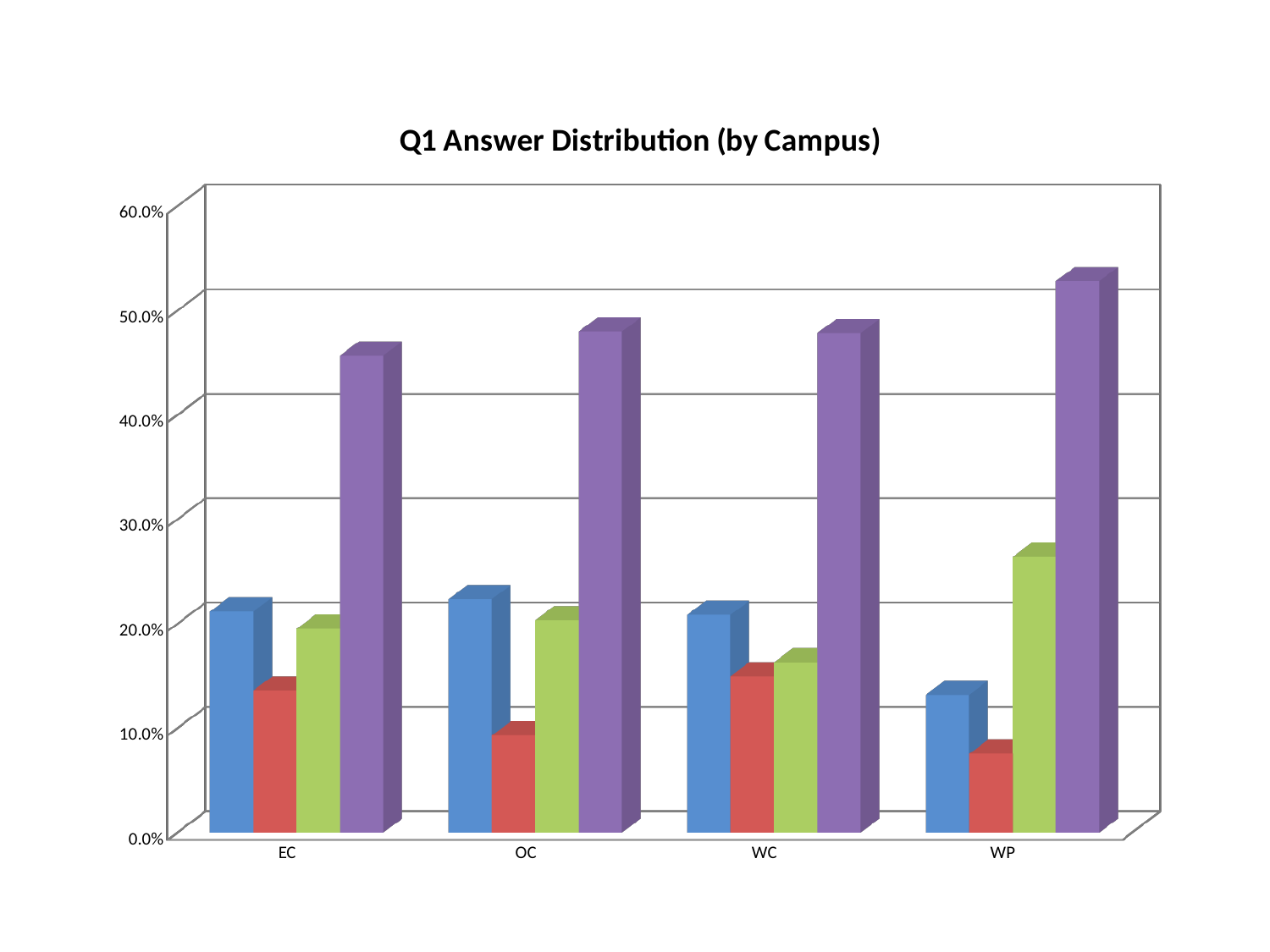
Which campus has the shortest red bar? WP Which is larger, the purple bar for WP or the purple bar for EC? WP Is the purple bar for WP greater or less than 50.0%? greater Is the red bar for WP greater or less than 10.0%? less How many bars are shown for each campus category? 4 What is the title of the chart? Q1 Answer Distribution (by Campus) What kind of chart is shown on the slide? bar chart Is the green bar for WP greater or less than 20.0%? greater How many campus categories are shown on the x axis? 4 Which is larger, the green bar for WP or the green bar for WC? WP Which campus has the tallest purple bar? WP